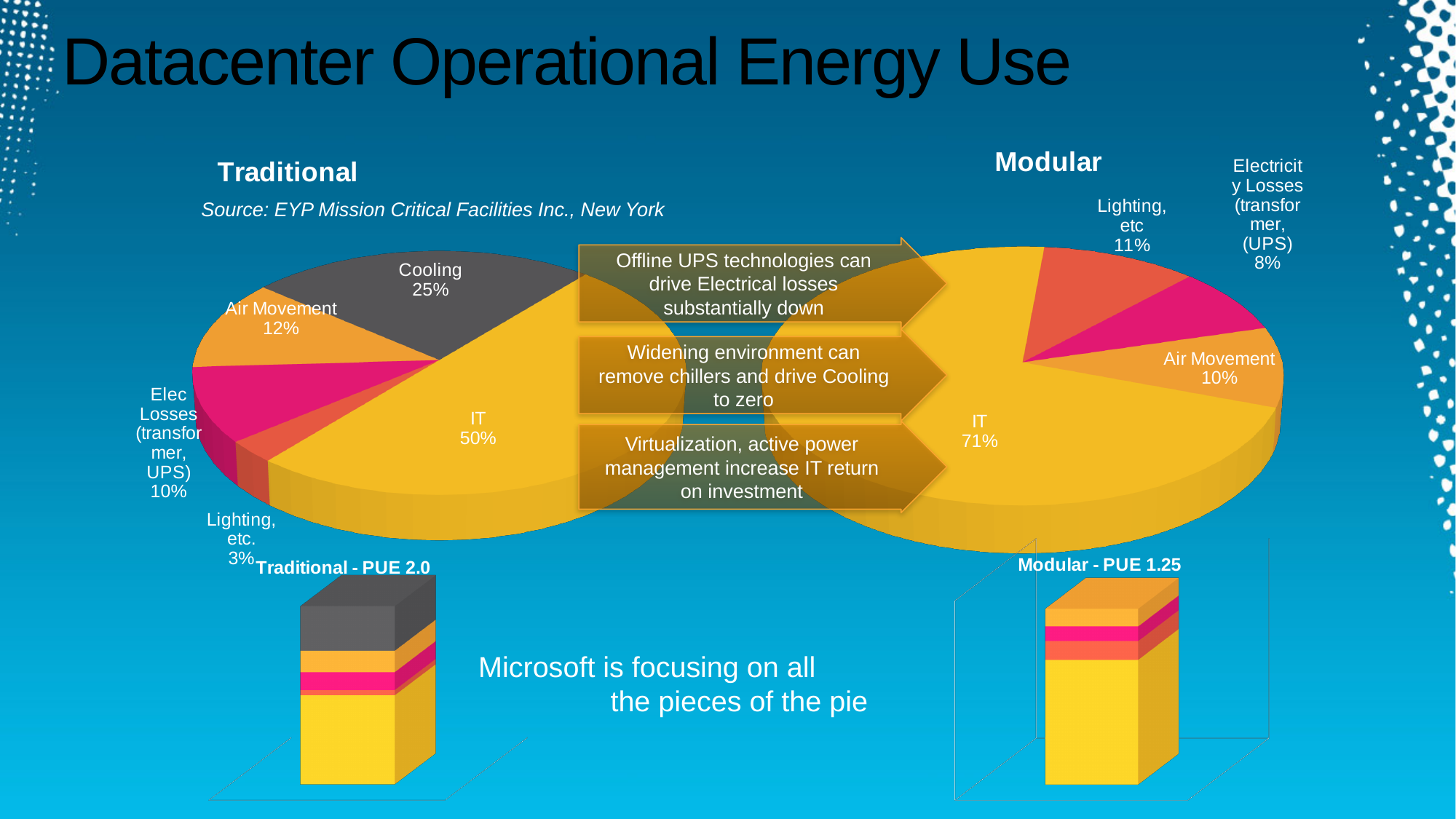
In the Traditional pie chart, which category has the smallest share? Lighting, etc. What type of chart is used to show the Traditional and Modular energy breakdowns? Pie chart How many slices does the Traditional pie chart have? 5 In the Traditional pie chart, which category has the largest share? IT What is the difference between the IT share in the Modular pie chart and the IT share in the Traditional pie chart? 21 percentage points In the Modular pie chart, what share of energy use is IT? 71% In the Modular pie chart, which category has the smallest share? Electricity Losses (transformer, UPS) In the Modular pie chart, what share of energy use is Lighting, etc? 11% In the Traditional pie chart, what share of energy use is IT? 50% In the Traditional pie chart, which is larger: Air Movement or Elec Losses (transformer, UPS)? Air Movement In the Traditional pie chart, what share of energy use is Cooling? 25% How many slices does the Modular pie chart have? 4